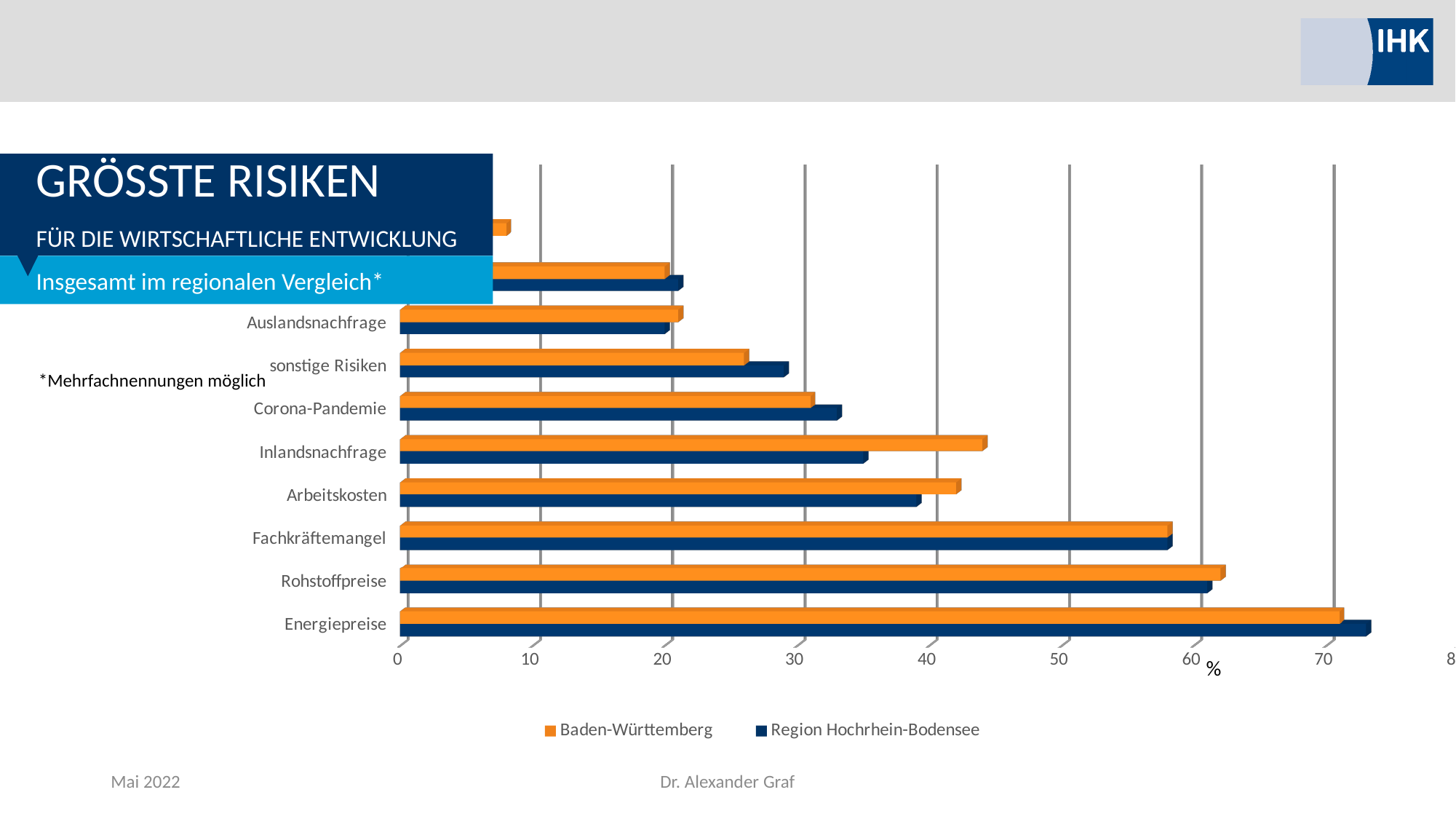
Is the value for Fachkräftemangel for Region Hochrhein-Bodensee greater or less than 50? greater For sonstige Risiken, which series has the larger value, Baden-Württemberg or Region Hochrhein-Bodensee? Region Hochrhein-Bodensee Which series is shown in orange in the legend? Baden-Württemberg What kind of chart is shown on the slide? bar chart Is the value for Inlandsnachfrage for Baden-Württemberg greater or less than 40? greater Which category has the highest value for Baden-Württemberg? Energiepreise Is the value for Inlandsnachfrage for Region Hochrhein-Bodensee greater or less than 40? less How many series does the legend list? 2 For Inlandsnachfrage, which series has the larger value, Baden-Württemberg or Region Hochrhein-Bodensee? Baden-Württemberg Which category has the highest value for Region Hochrhein-Bodensee? Energiepreise